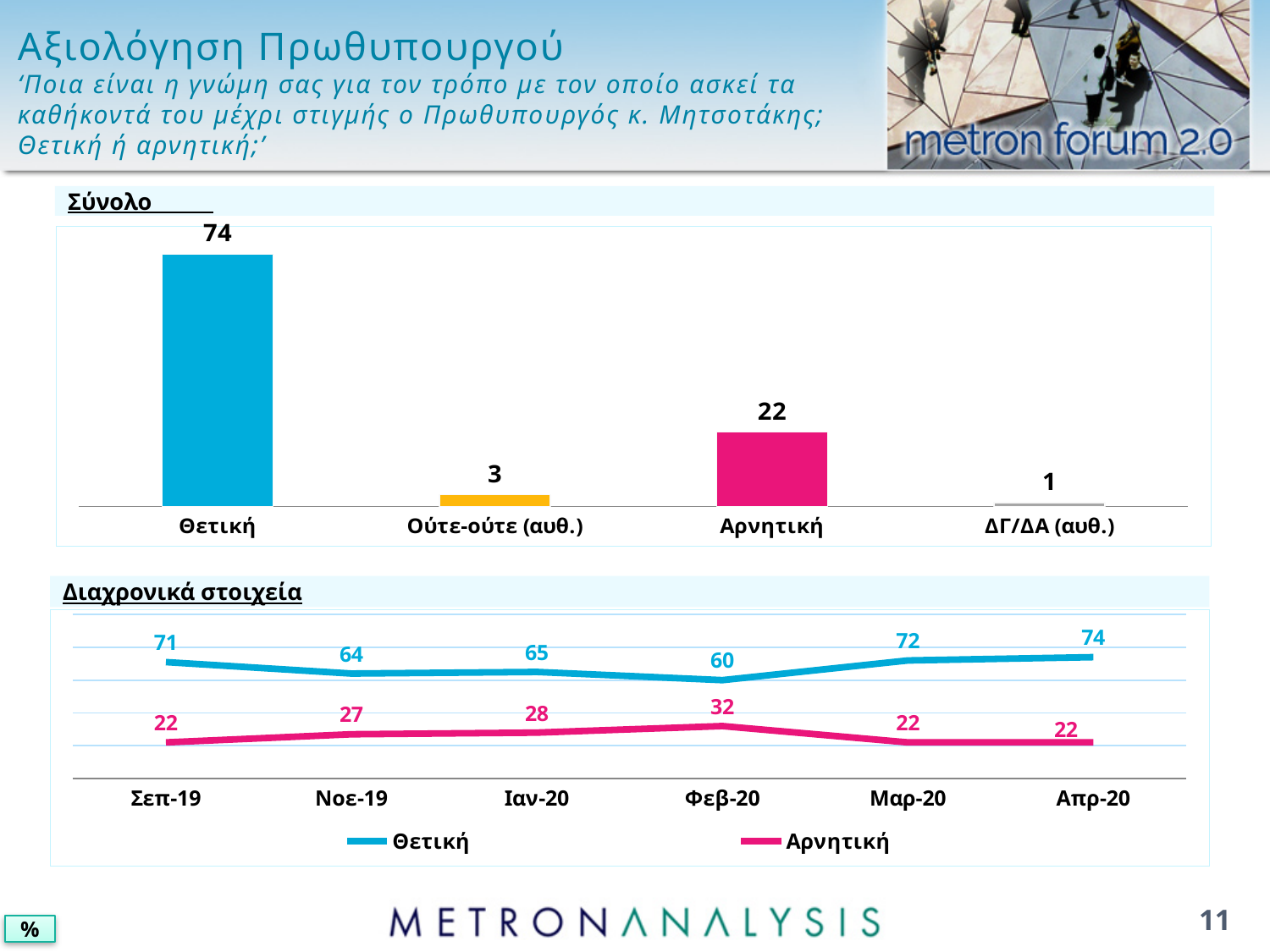
In the 'Διαχρονικά στοιχεία' line chart, in which month is Αρνητική highest? Φεβ-20 In the 'Διαχρονικά στοιχεία' line chart, how many series does the legend list? 2 In the 'Διαχρονικά στοιχεία' line chart, how many time points are shown on the x axis? 6 In the 'Σύνολο' bar chart, what is the value for Θετική? 74 In the 'Διαχρονικά στοιχεία' line chart, what is the value for Αρνητική in Ιαν-20? 28 In the 'Σύνολο' bar chart, how many categories are shown? 4 In the 'Διαχρονικά στοιχεία' line chart, what is the value for Θετική in Φεβ-20? 60 In the 'Σύνολο' bar chart, what is the value for Αρνητική? 22 In the 'Διαχρονικά στοιχεία' line chart, does Θετική rise or fall from Φεβ-20 to Απρ-20? rise What kind of chart is the 'Σύνολο' chart? bar chart In the 'Σύνολο' bar chart, what is the difference between Θετική and Αρνητική? 52 In the 'Σύνολο' bar chart, which category has the lowest value? ΔΓ/ΔΑ (αυθ.)